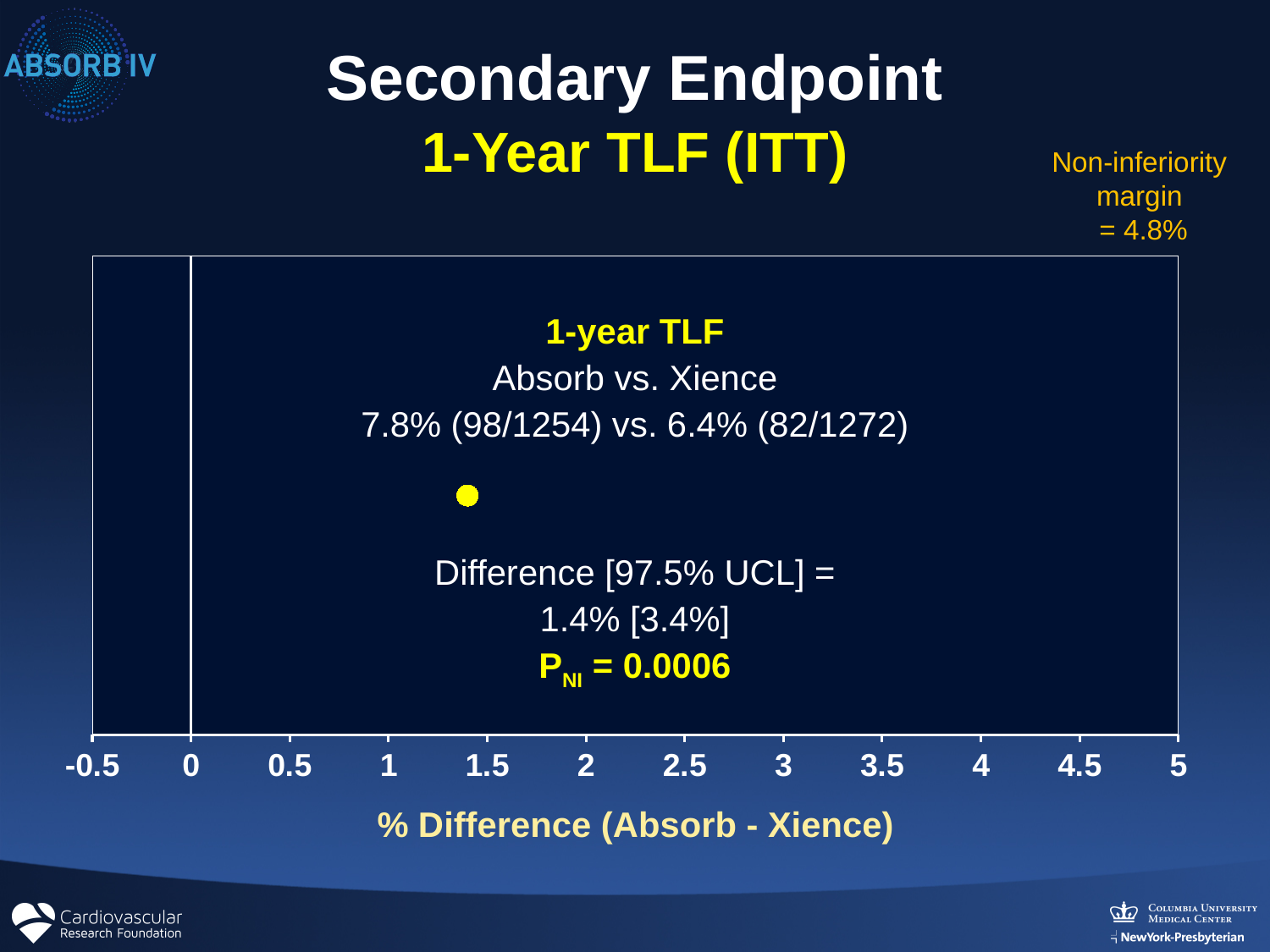
What is the difference between the Absorb and Xience 1-year TLF rates? 1.4% What is the title of the x axis on the chart? % Difference (Absorb - Xience) What is the 97.5% upper confidence limit (UCL) for the difference shown on the chart? 3.4% Which has the higher 1-year TLF rate, Absorb or Xience? Absorb Is the plotted point for 1-year TLF greater or less than 2 on the x axis? less What non-inferiority margin is stated on the slide? 4.8% What is the P value for non-inferiority (P NI) shown on the chart? 0.0006 How many data points are plotted on the chart? 1 What is the 1-year TLF rate for Absorb shown on the chart? 7.8% Is the plotted point for 1-year TLF greater or less than 1 on the x axis? greater What is the plotted % difference (Absorb - Xience) for 1-year TLF? 1.4% What is the 1-year TLF rate for Xience shown on the chart? 6.4%